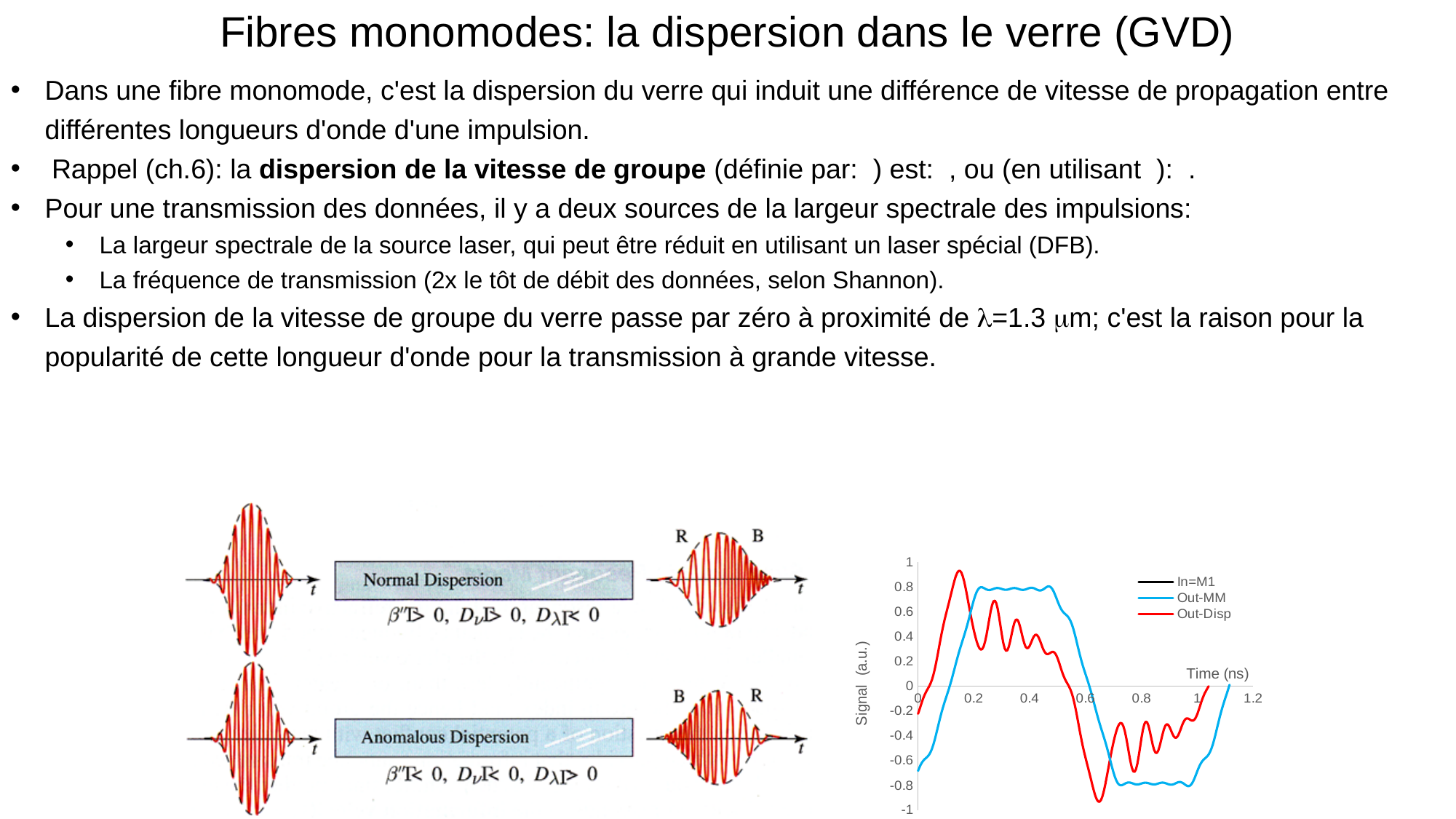
In the chart on the right, which series is drawn in red? Out-Disp In the chart on the right, at 0.8 ns, which series has the larger value, Out-MM or Out-Disp? Out-Disp In the chart on the right, is the value of the Out-MM series at 0.3 ns greater or less than 0.6? greater In the chart on the right, is the value of the Out-Disp series at 0.7 ns greater or less than 0? less In the chart on the right, does the Out-MM series rise or fall between 0.5 ns and 0.7 ns? fall What is the label of the vertical axis of the chart on the right? Signal (a.u.) In the chart on the right, is the value of the Out-Disp series at 0.4 ns greater or less than 0.2? greater In the chart on the right, at 0.3 ns, which series has the larger value, Out-MM or Out-Disp? Out-MM How many series does the legend of the chart on the right list? 3 What kind of chart is shown on the right side of the slide? line chart